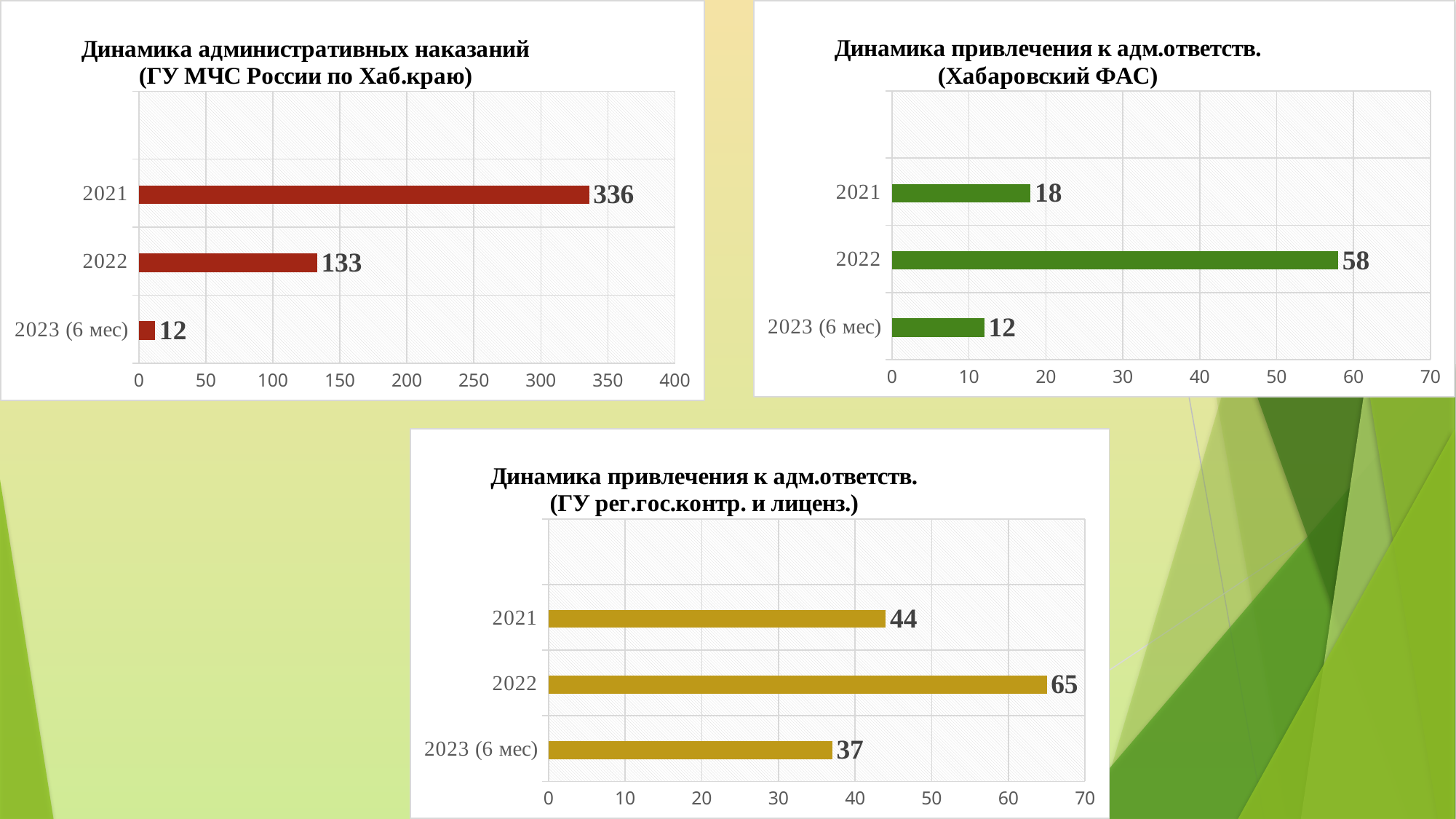
In the chart titled 'Динамика привлечения к адм.ответств. (ГУ рег.гос.контр. и лиценз.)', how many categories are shown? 3 What kind of chart is the chart titled 'Динамика привлечения к адм.ответств. (ГУ рег.гос.контр. и лиценз.)'? bar chart In the chart titled 'Динамика привлечения к адм.ответств. (Хабаровский ФАС)', which is larger, the value for 2021 or the value for 2023 (6 мес)? 2021 In the chart titled 'Динамика привлечения к адм.ответств. (ГУ рег.гос.контр. и лиценз.)', what is the value for 2023 (6 мес)? 37 In the chart titled 'Динамика привлечения к адм.ответств. (Хабаровский ФАС)', which category has the highest value? 2022 How many charts are shown on the slide? 3 In the chart titled 'Динамика привлечения к адм.ответств. (Хабаровский ФАС)', what is the value for 2022? 58 In the chart titled 'Динамика административных наказаний (ГУ МЧС России по Хаб.краю)', which category has the lowest value? 2023 (6 мес) In the chart titled 'Динамика административных наказаний (ГУ МЧС России по Хаб.краю)', what is the value for 2022? 133 In the chart titled 'Динамика административных наказаний (ГУ МЧС России по Хаб.краю)', what is the difference between the values for 2021 and 2022? 203 In the chart titled 'Динамика административных наказаний (ГУ МЧС России по Хаб.краю)', what is the value for 2021? 336 In the chart titled 'Динамика привлечения к адм.ответств. (ГУ рег.гос.контр. и лиценз.)', what is the difference between the values for 2022 and 2021? 21